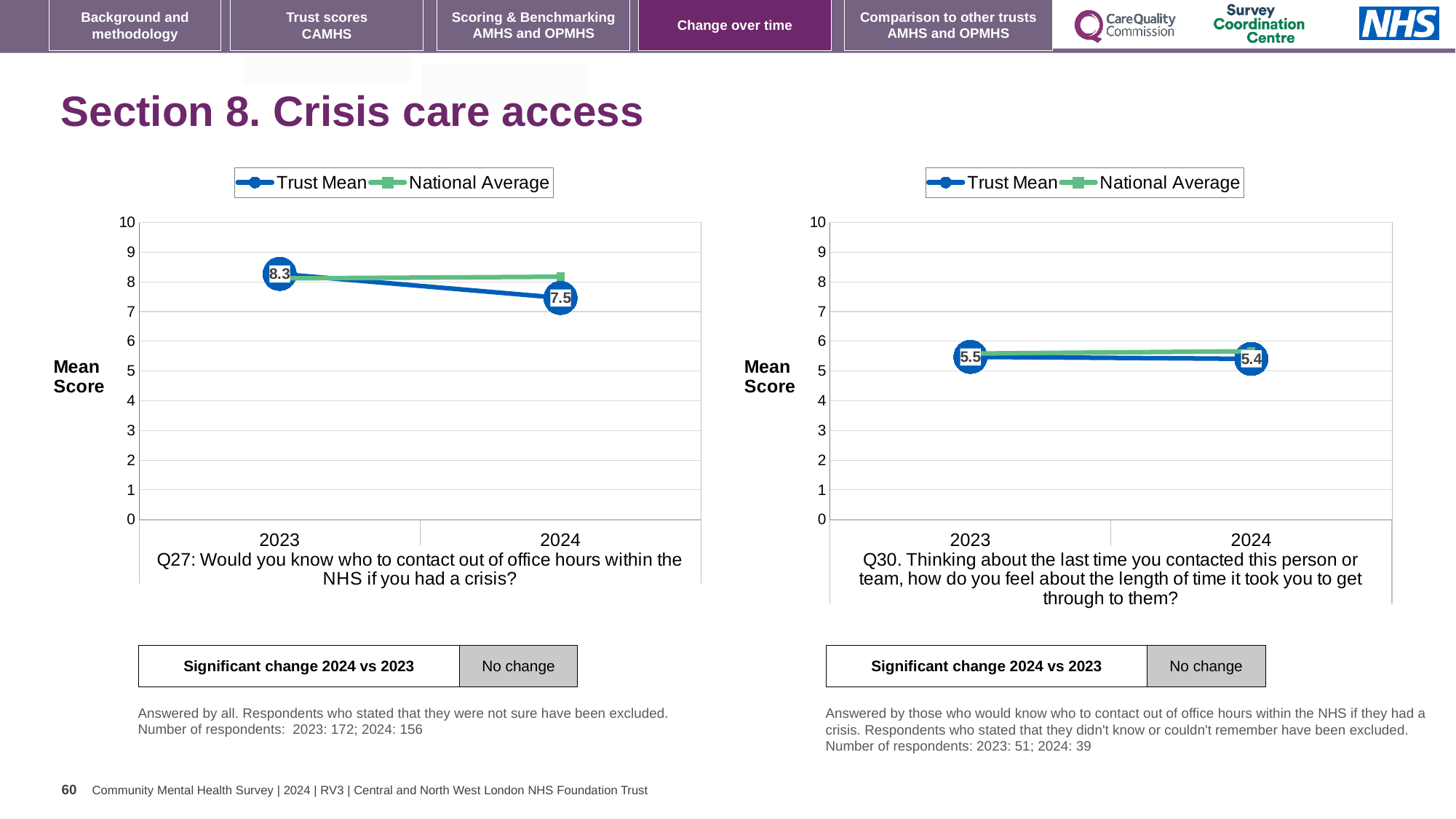
In the Q27 chart on the left, what is the Trust Mean score for 2023? 8.3 In the Q30 chart on the right, what is the Trust Mean score for 2024? 5.4 In the Q27 chart on the left, which year has the higher Trust Mean score, 2023 or 2024? 2023 How many years are shown on the x axis of the Q27 chart on the left? 2 In the Q27 chart on the left, does the Trust Mean rise or fall from 2023 to 2024? fall In the Q27 chart on the left, what is the Trust Mean score for 2024? 7.5 In the Q27 chart on the left, by how much did the Trust Mean score fall from 2023 to 2024? 0.8 What type of chart is the Q30 chart on the right? line chart In the Q30 chart on the right, what is the Trust Mean score for 2023? 5.5 How many series does the legend of the Q27 chart on the left list? 2 In the Q30 chart on the right, what is the difference between the Trust Mean scores for 2023 and 2024? 0.1 In the Q30 chart on the right, is the National Average for 2024 greater or less than 7? less